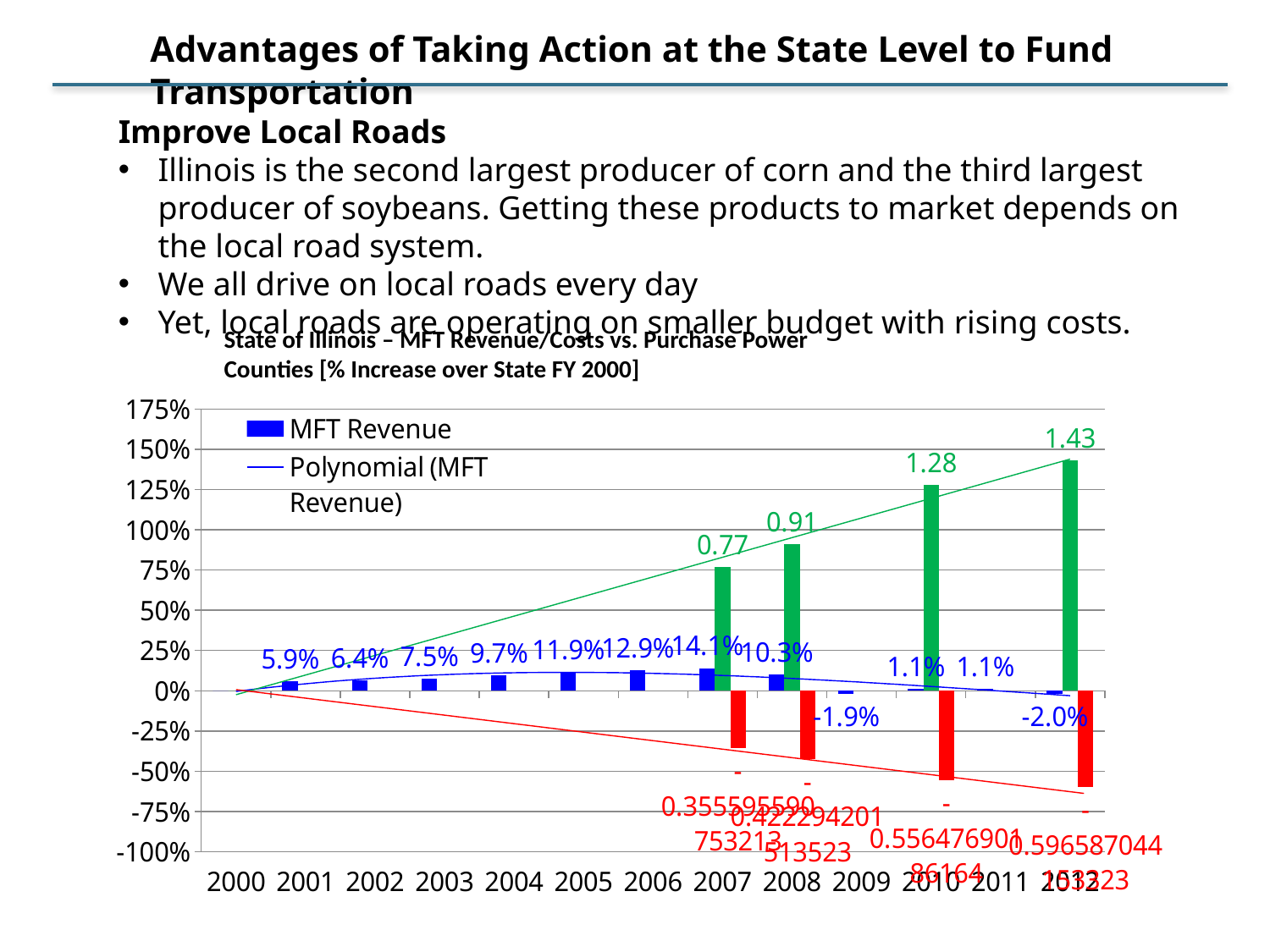
Which year has the highest MFT Revenue value? 2007 What is the MFT Revenue value for 2007? 14.1% What value is labelled on the green bar for 2010? 1.28 Do the MFT Revenue values rise or fall from 2001 to 2007? rise Is the value of the green bar for 2012 greater or less than 125%? greater Which year has the lowest MFT Revenue value? 2012 What is the difference between the MFT Revenue values for 2007 and 2001? 8.2 percentage points Which year has the larger MFT Revenue value, 2005 or 2006? 2006 What is the MFT Revenue value for 2001? 5.9% How many series does the legend list? 2 How many years are shown on the x axis? 13 What value is labelled on the green bar for 2012? 1.43